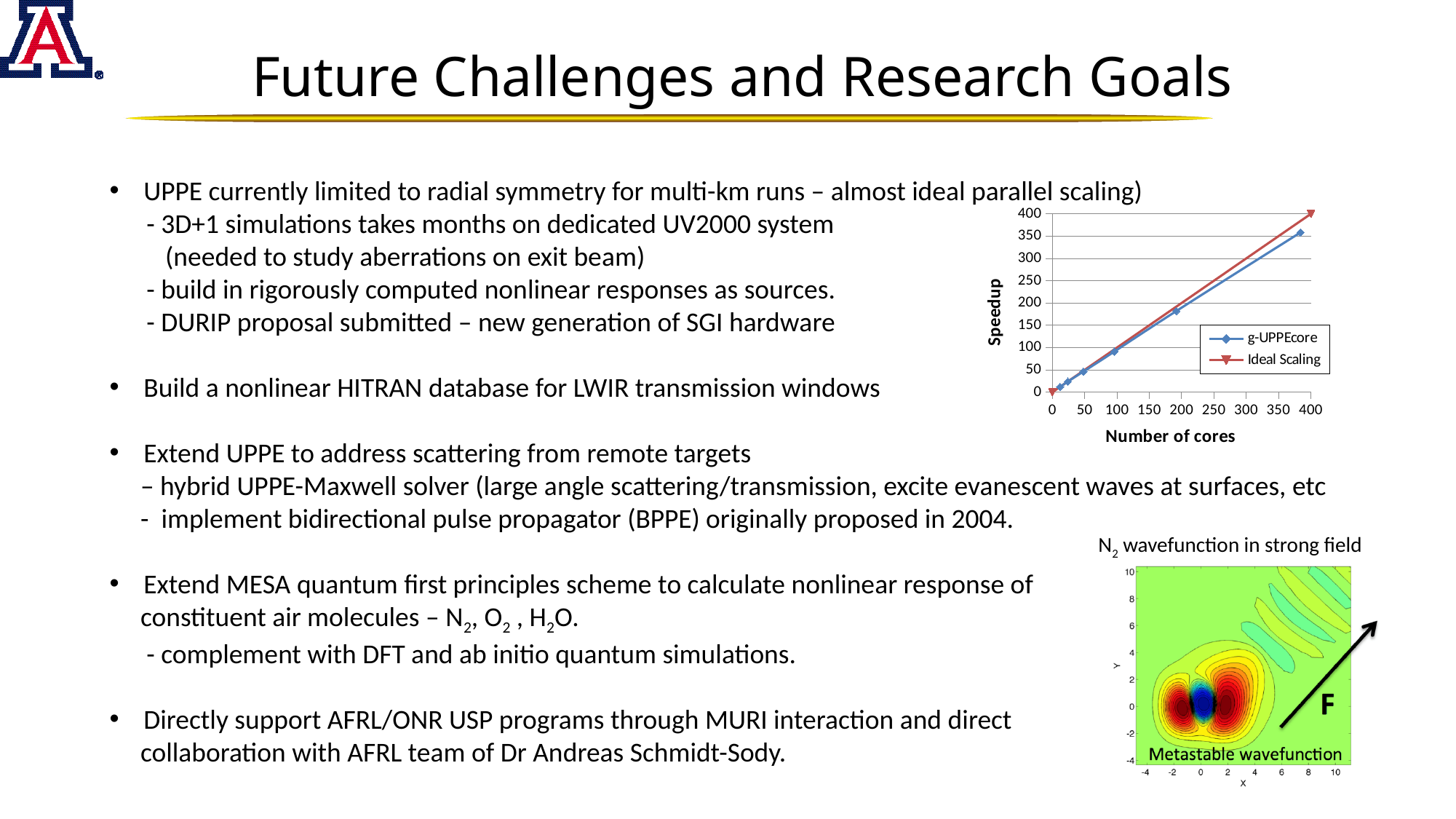
In the Speedup chart, is the g-UPPEcore speedup at 100 cores greater or less than 150? less What are the two series named in the legend of the Speedup chart? g-UPPEcore and Ideal Scaling What is the label of the x axis of the Speedup chart? Number of cores In the Speedup chart, is the g-UPPEcore speedup at 400 cores greater or less than 300? greater What kind of chart is the Speedup versus Number of cores chart? line chart In the Speedup chart, at 400 cores, which series has the higher speedup, g-UPPEcore or Ideal Scaling? Ideal Scaling In the Speedup chart, is the g-UPPEcore speedup at 200 cores greater or less than 150? greater In the Speedup chart, does the g-UPPEcore speedup rise or fall as the number of cores increases? rise What is the highest value shown on the y axis of the Speedup chart? 400 How many series does the legend of the Speedup chart list? 2